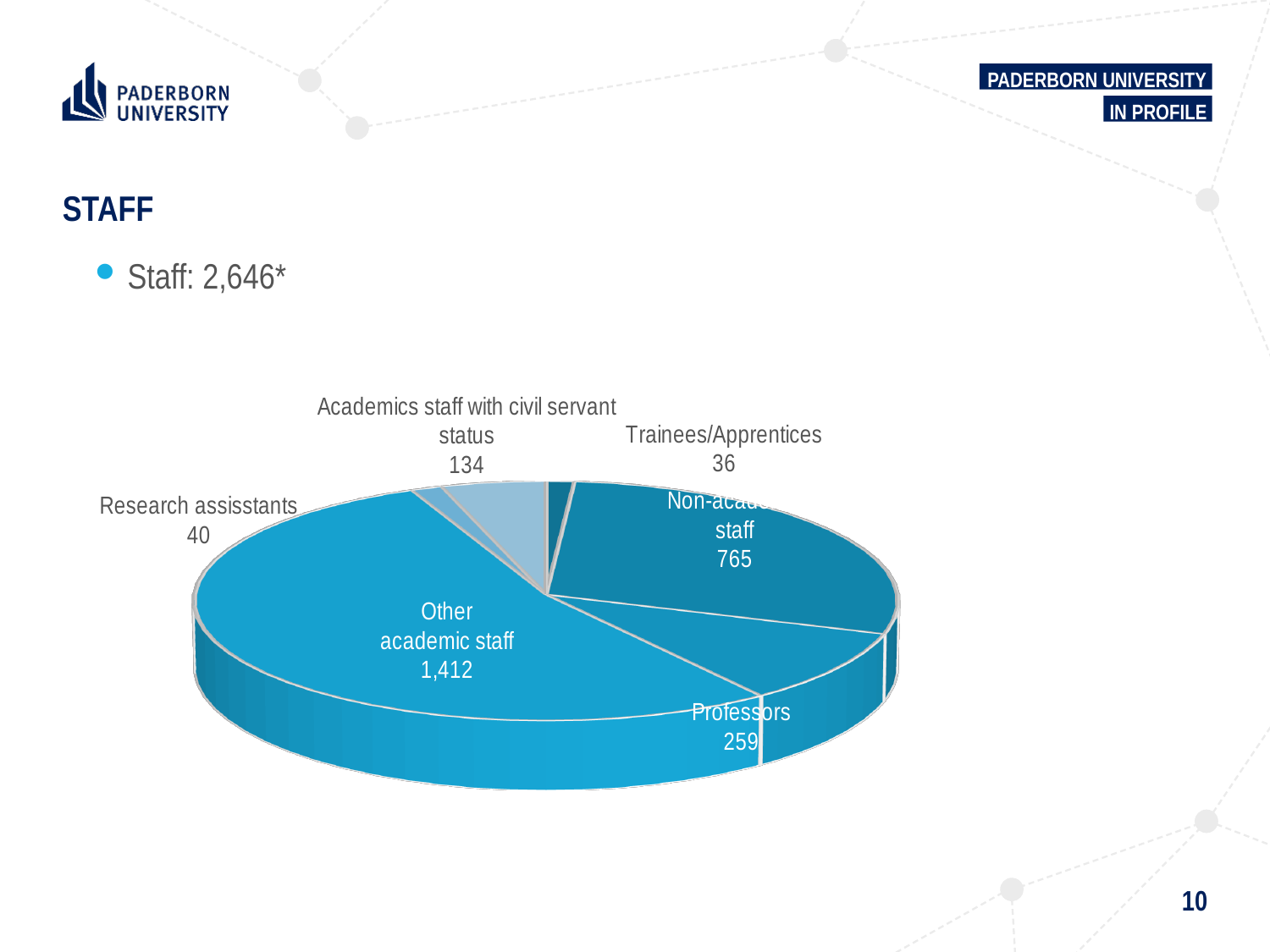
What is the difference between Non-academic staff and Professors? 506 Which is larger, Academics staff with civil servant status or Research assistants? Academics staff with civil servant status What is the value for Other academic staff? 1,412 What total staff number is stated on the slide? 2,646 What is the value for Research assistants? 40 What is the value for Professors? 259 How many categories does the pie chart show? 6 Which category has the smallest slice of the pie? Trainees/Apprentices What is the value for Academics staff with civil servant status? 134 Which category has the largest slice of the pie? Other academic staff What is the value for Trainees/Apprentices? 36 What type of chart is shown on the slide? Pie chart